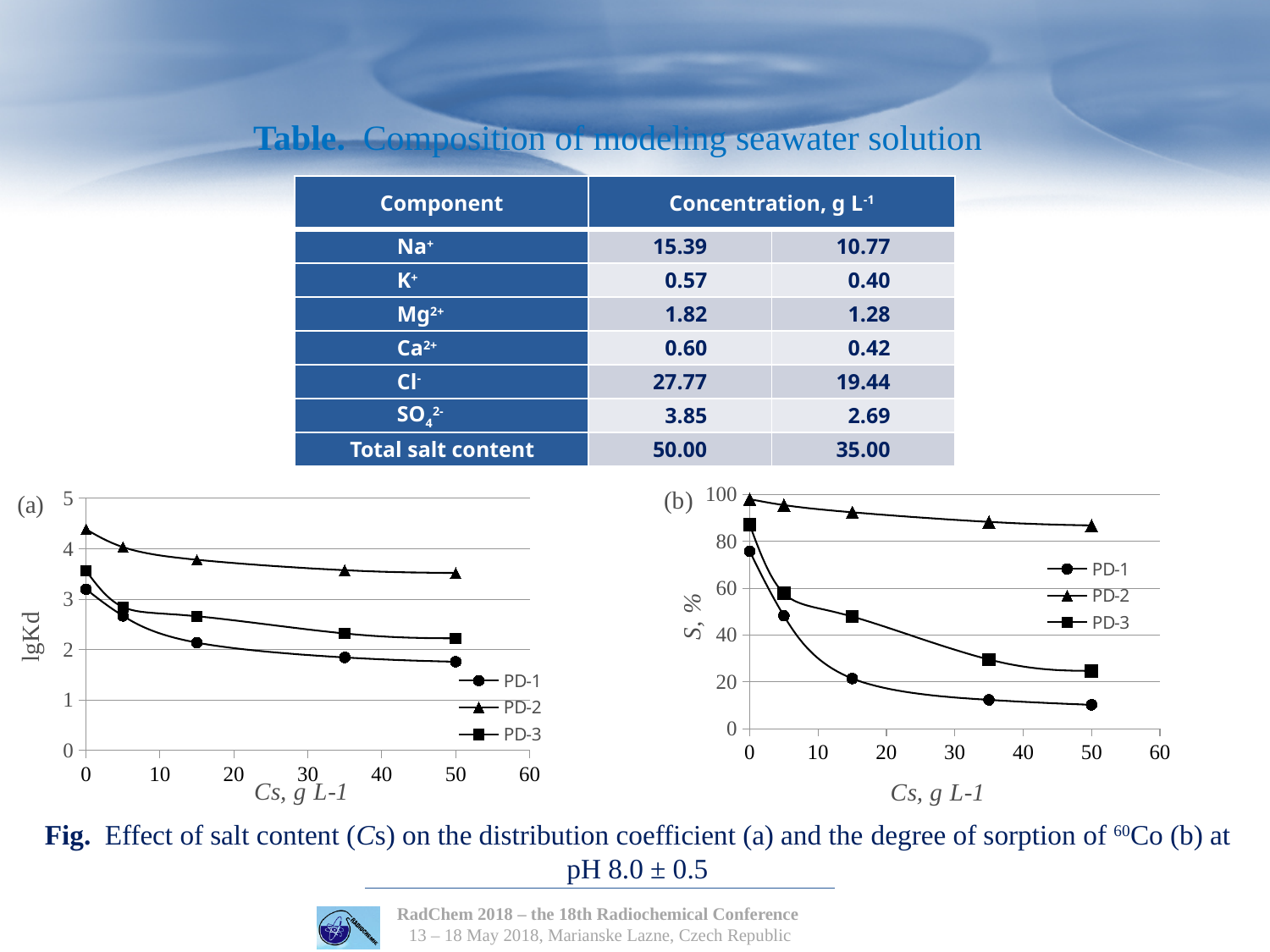
In chart (a), is the lgKd value for PD-2 at Cs = 0 greater or less than 4? greater In chart (a), how many data points are plotted for the PD-2 series? 5 In chart (a), do the lgKd values for PD-3 rise or fall as Cs increases? fall How many series does the legend of chart (b) on the right list? 3 In chart (b), is the S, % value for PD-1 at Cs = 50 greater or less than 20? less In chart (a), which series has the highest lgKd values across the whole Cs range? PD-2 In chart (a), is the lgKd value for PD-1 at Cs = 50 greater or less than 2? less What kind of chart is chart (a) on the left of the slide? line chart What is the label of the y axis of chart (b)? S, % In chart (b), which series has the lowest S, % value at Cs = 50 g L-1? PD-1 In chart (b), which series has the larger S, % value at Cs = 0: PD-1 or PD-2? PD-2